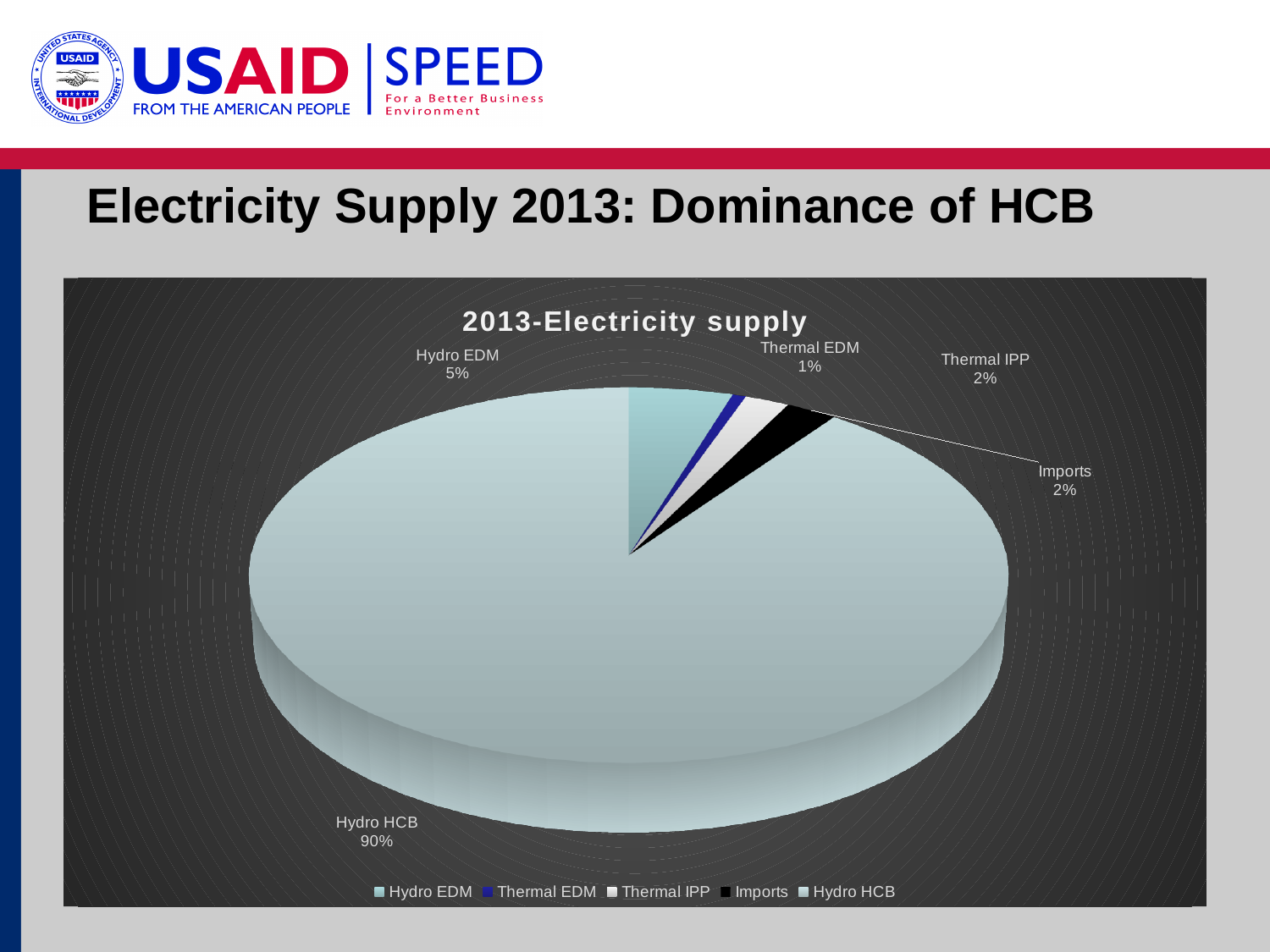
What is the difference in percentage points between the Hydro HCB share and the Hydro EDM share? 85 percentage points What share of the 2013 electricity supply comes from Thermal EDM? 1% Which source has the smallest share of the 2013 electricity supply? Thermal EDM What kind of chart is shown on the slide? Pie chart What is the title of the chart? 2013-Electricity supply Which source has the largest share of the 2013 electricity supply? Hydro HCB Which has a larger share of the 2013 electricity supply, Hydro EDM or Thermal IPP? Hydro EDM What share of the 2013 electricity supply comes from Thermal IPP? 2% What share of the 2013 electricity supply comes from Hydro HCB? 90% What share of the 2013 electricity supply comes from Imports? 2% What share of the 2013 electricity supply comes from Hydro EDM? 5% How many sources (slices) are shown in the pie chart? 5